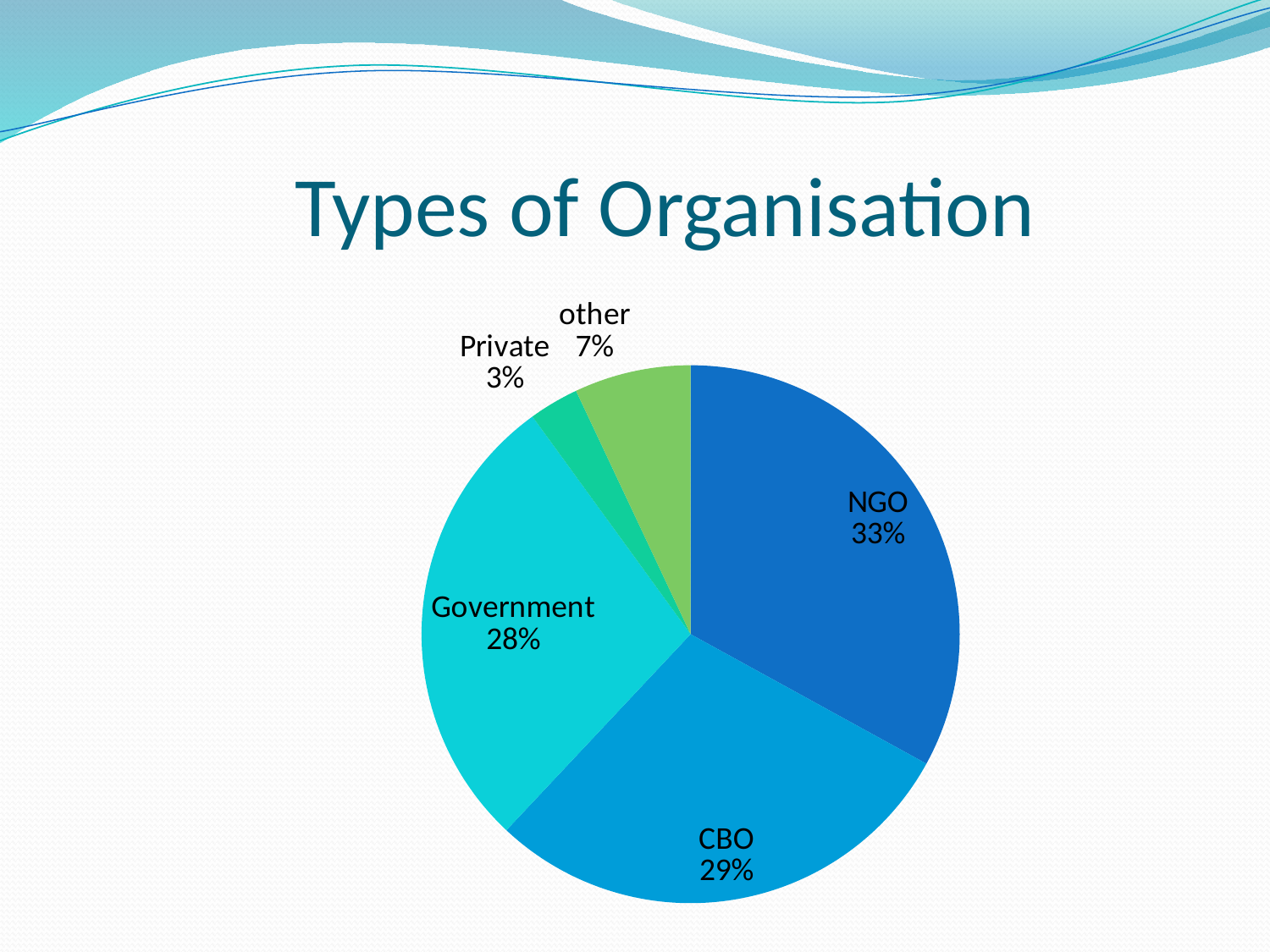
What is the difference in percentage points between CBO and other? 22 What share of the pie does NGO represent? 33% Which type of organisation has the smallest share? Private How many slices does the pie chart have? 5 What percentage is shown for Government? 28% What is the difference in percentage points between NGO and Government? 5 Which type of organisation has the largest share? NGO What kind of chart is shown on the slide? Pie chart Which is larger, the share for CBO or the share for Government? CBO What is the title of the slide? Types of Organisation What percentage is shown for the 'other' slice? 7% What percentage is shown for Private? 3%